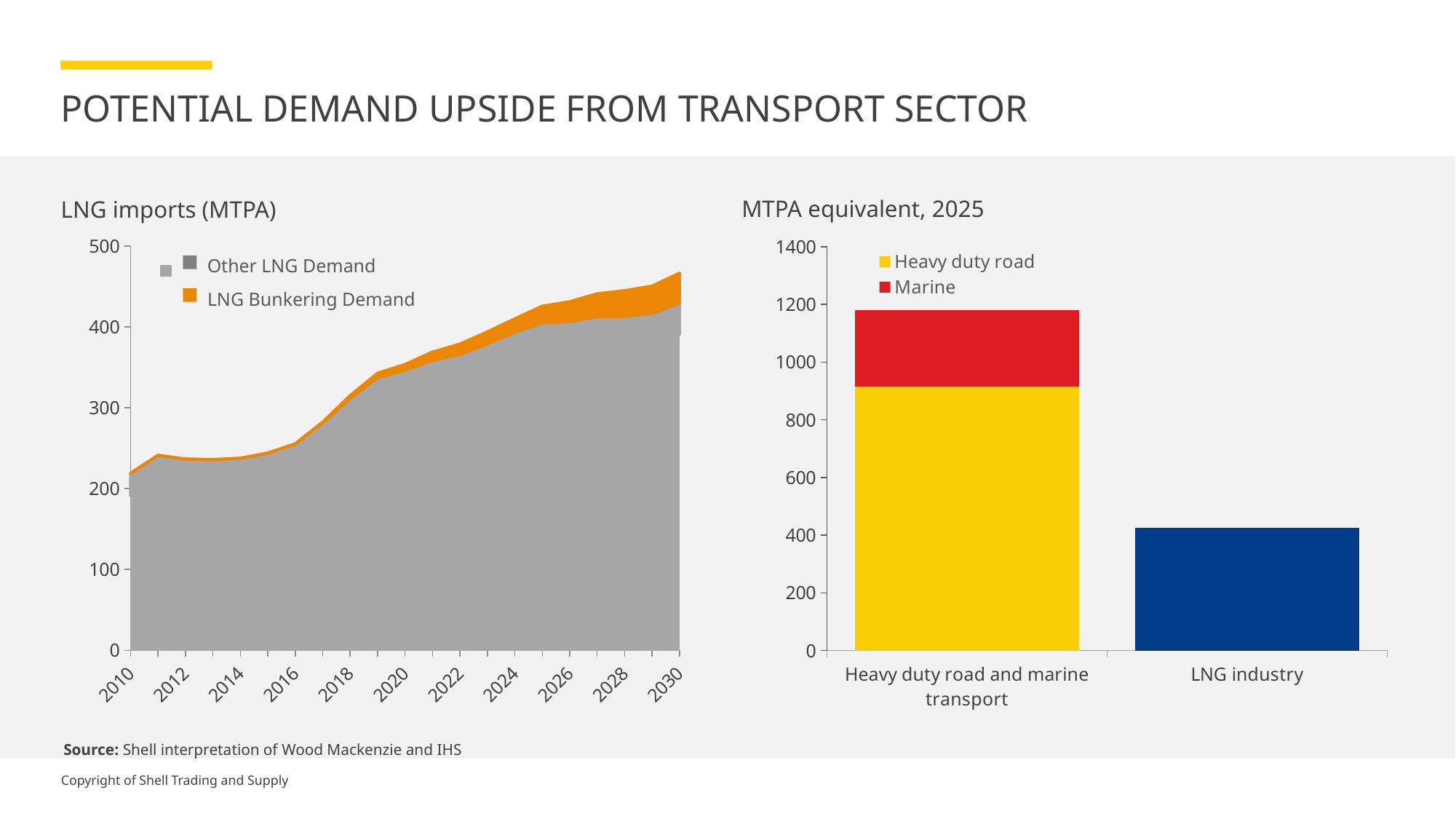
In the 'LNG imports (MTPA)' chart, do total LNG imports rise or fall from 2010 to 2030? Rise In the 'MTPA equivalent, 2025' chart, how many series does the legend list? 2 In the 'MTPA equivalent, 2025' chart, how many categories are shown on the x axis? 2 In the 'LNG imports (MTPA)' chart, is the total LNG import value in 2010 greater or less than 300? less In the 'MTPA equivalent, 2025' chart, is the total for 'Heavy duty road and marine transport' greater or less than 1000? greater In the 'LNG imports (MTPA)' chart, which colour represents 'LNG Bunkering Demand'? Orange In the 'MTPA equivalent, 2025' chart, which bar is taller: 'Heavy duty road and marine transport' or 'LNG industry'? Heavy duty road and marine transport What kind of chart is the 'LNG imports (MTPA)' chart on the left? Area chart In the 'MTPA equivalent, 2025' chart, is the value for 'LNG industry' greater or less than 600? less In the 'LNG imports (MTPA)' chart, how many series does the legend list? 2 What kind of chart is the 'MTPA equivalent, 2025' chart on the right? Stacked bar chart